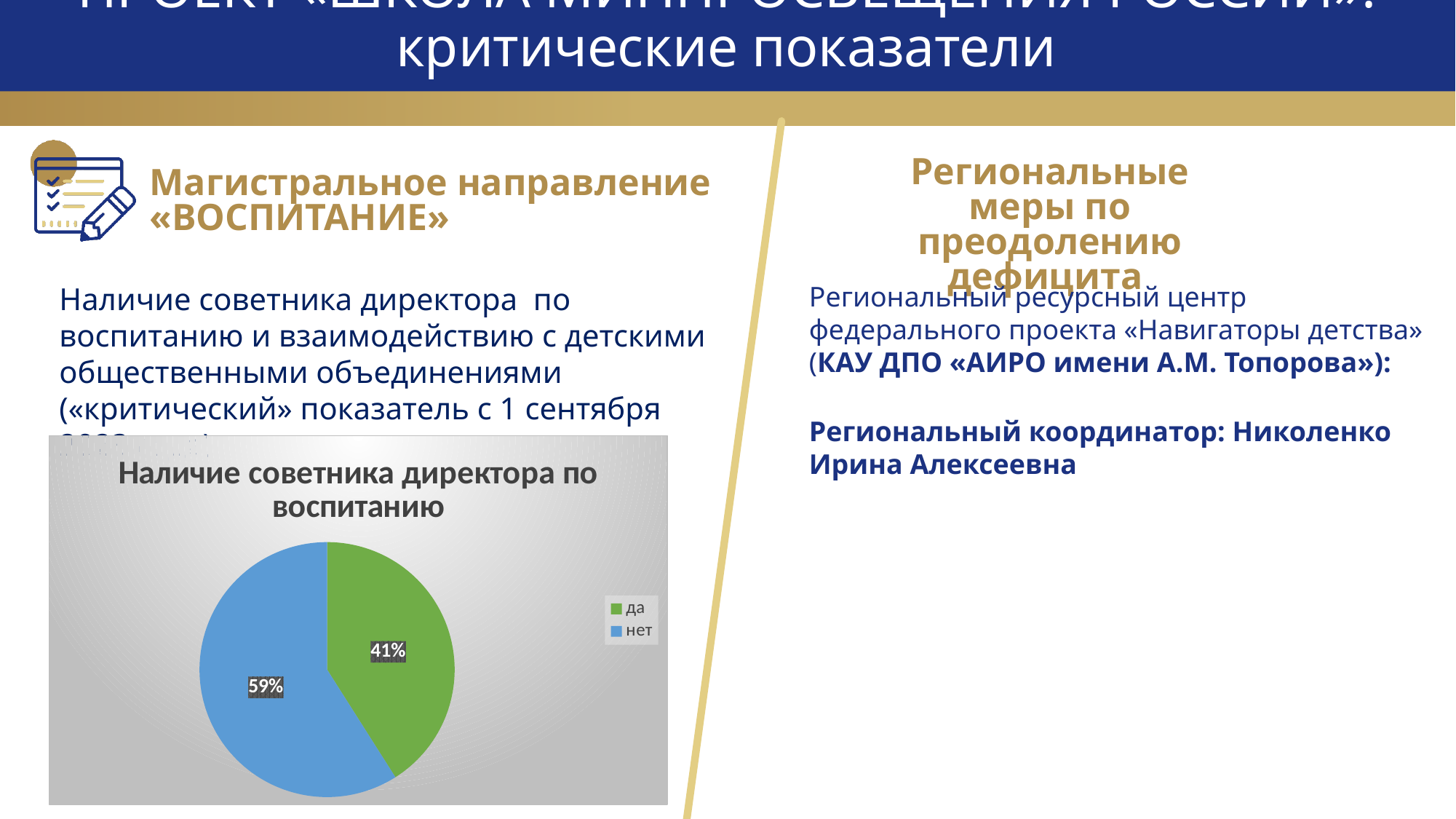
What colour is the "нет" slice in the pie chart? blue How many slices does the pie chart have? 2 Is the value for "да" greater or less than 50%? less Which slice is the largest in the pie chart? нет What share of the pie does the "да" slice represent? 41% Which is larger, the "да" slice or the "нет" slice? нет What share of the pie does the "нет" slice represent? 59% What kind of chart is shown on the slide? pie chart What is the difference in percentage points between the "нет" and "да" slices? 18% What is the title of the chart? Наличие советника директора по воспитанию How many entries does the legend list? 2 Which slice is the smallest in the pie chart? да